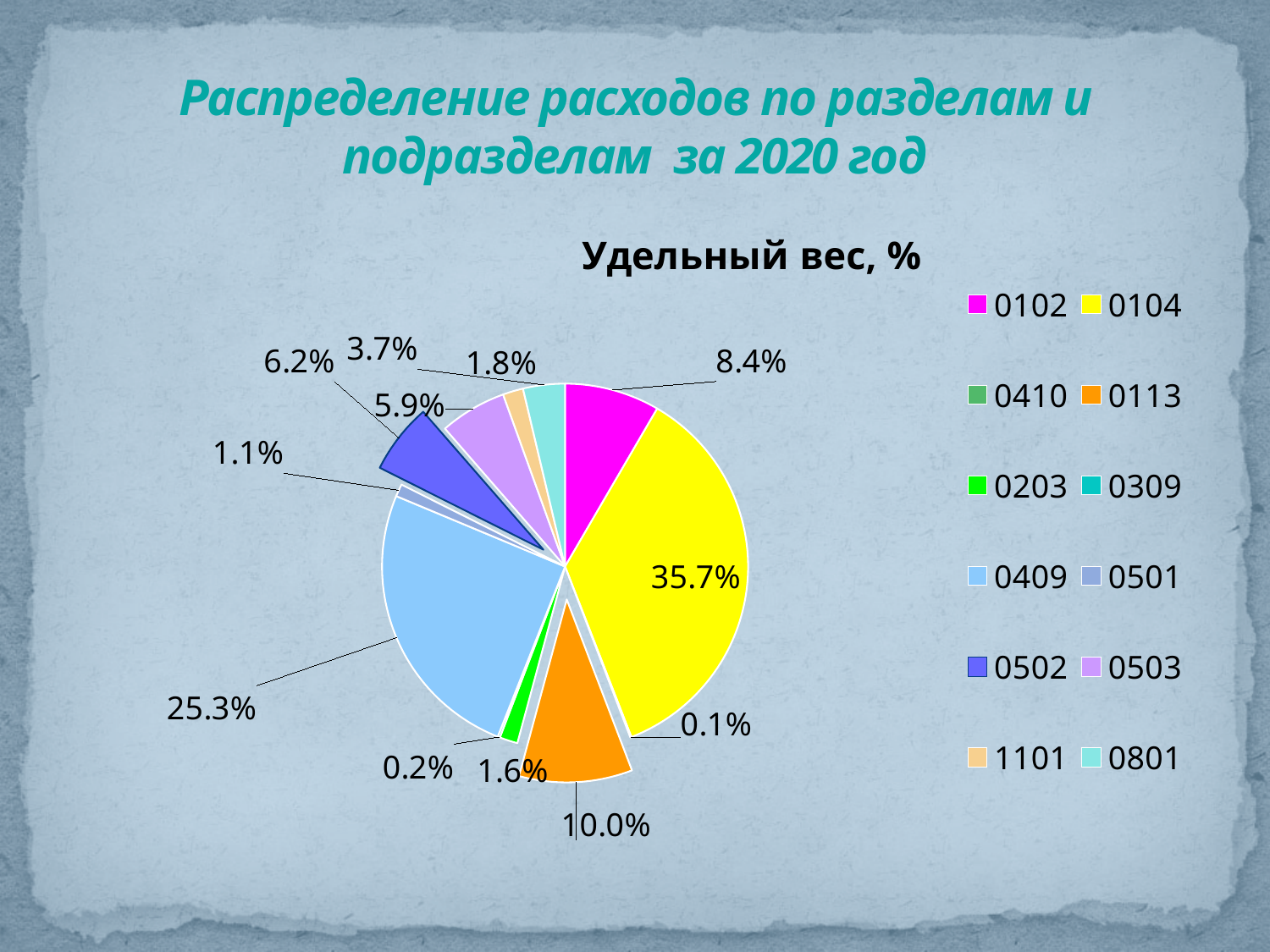
What is the share for category 0104? 35.7% Which category has the largest share of the pie? 0104 What is the share for category 0409? 25.3% How many categories does the legend list? 12 What is the share for category 0113? 10.0% Which is larger, the share for 0409 or the share for 0113? 0409 What is the share for category 0102? 8.4% What is the title of the chart? Удельный вес, % What type of chart is shown on the slide? pie chart What is the share for category 0501? 1.1% What is the share for category 0203? 1.6% What is the difference between the shares for 0104 and 0409? 10.4 percentage points